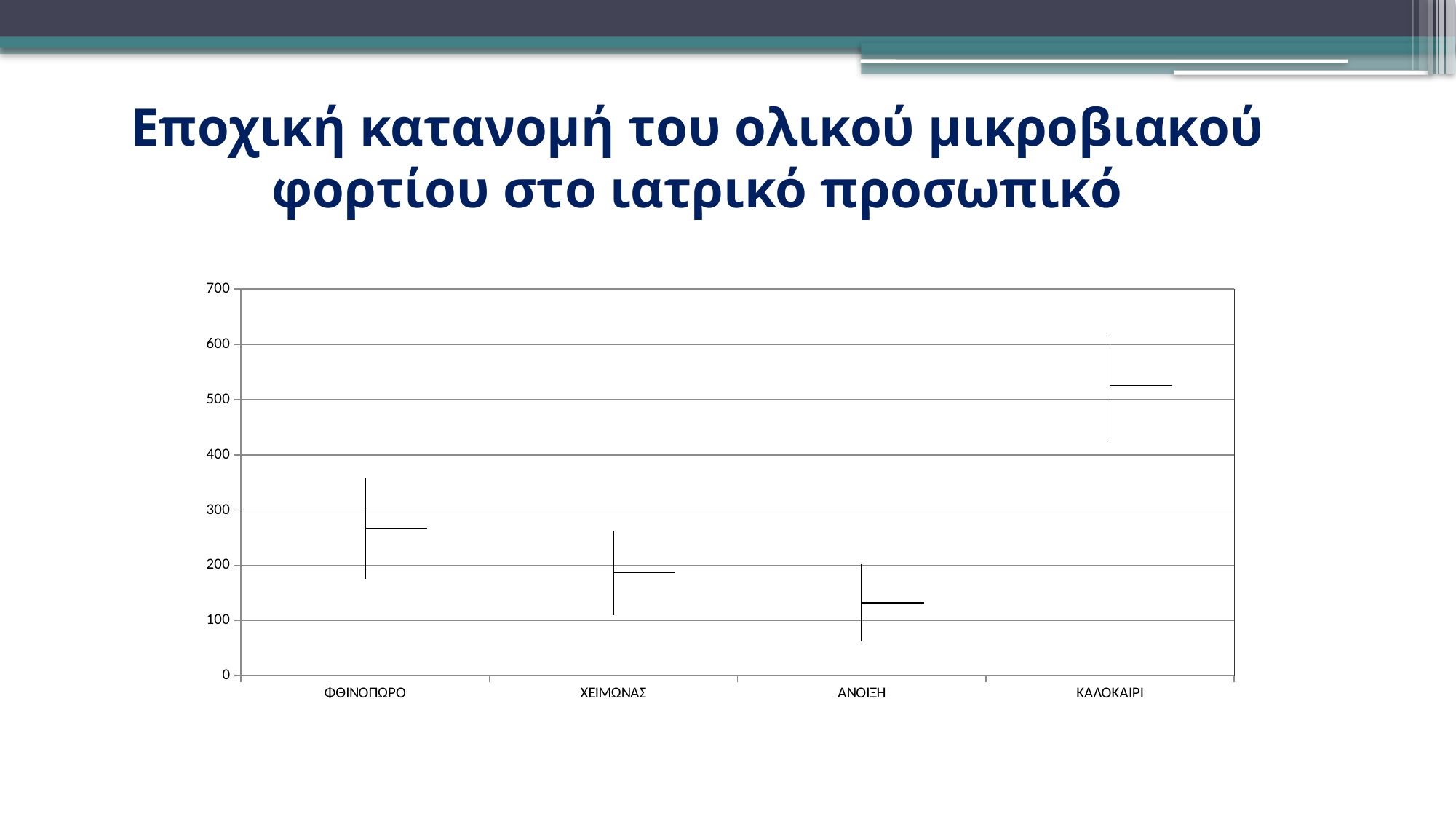
Which category has the lowest value on the chart? ΑΝΟΙΞΗ Do the values rise or fall from ΦΘΙΝΟΠΩΡΟ to ΑΝΟΙΞΗ? fall What is the title of the slide containing the chart? Εποχική κατανομή του ολικού μικροβιακού φορτίου στο ιατρικό προσωπικό What is the maximum value shown on the y axis of the chart? 700 Which is larger, the value for ΦΘΙΝΟΠΩΡΟ or the value for ΧΕΙΜΩΝΑΣ? ΦΘΙΝΟΠΩΡΟ Which is larger, the value for ΑΝΟΙΞΗ or the value for ΚΑΛΟΚΑΙΡΙ? ΚΑΛΟΚΑΙΡΙ Is the value for ΧΕΙΜΩΝΑΣ greater or less than 100? greater How many categories are shown on the x axis of the chart? 4 Which category has the highest value on the chart? ΚΑΛΟΚΑΙΡΙ